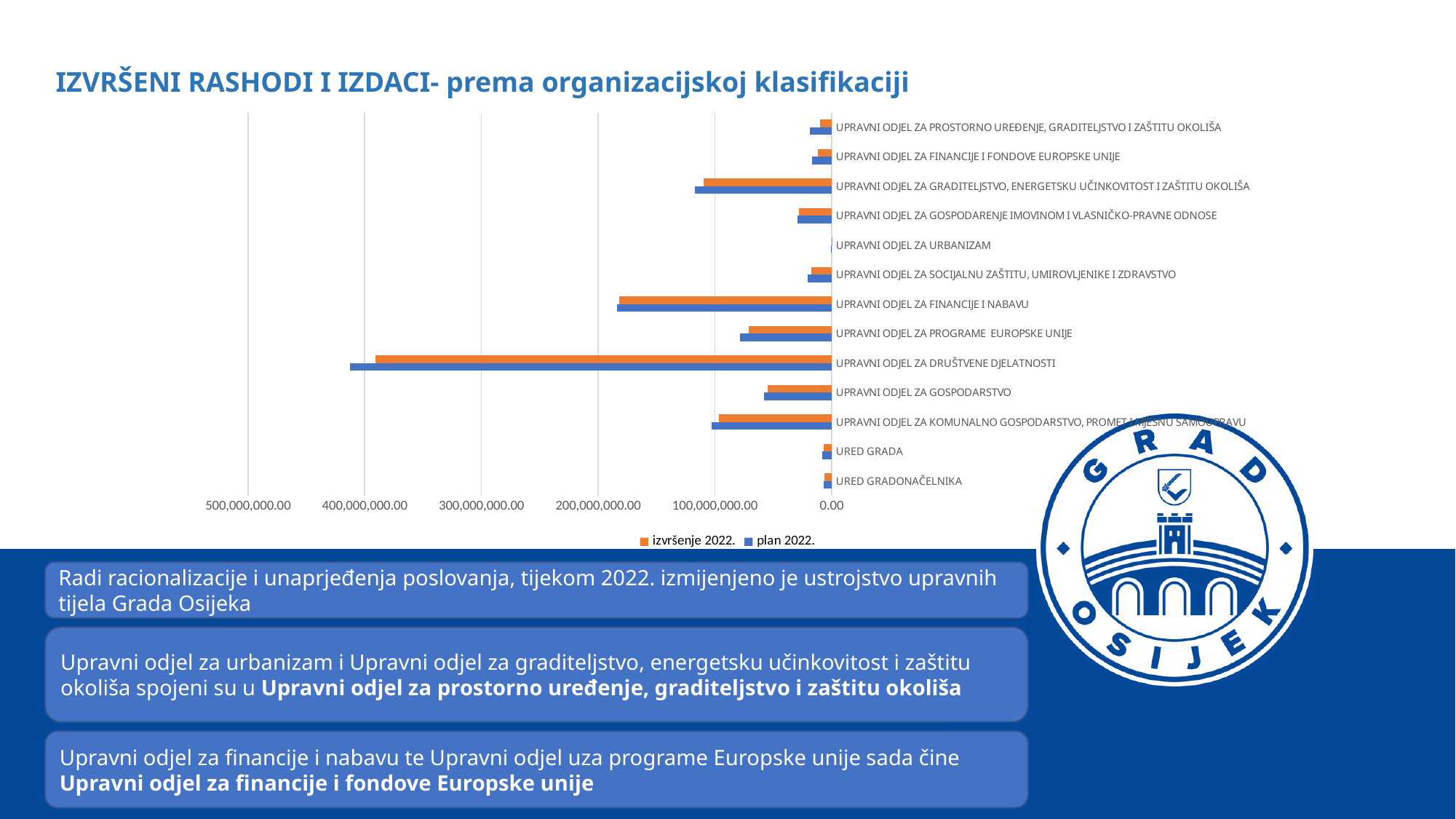
What are the two series named in the chart legend? izvršenje 2022. and plan 2022. How many series does the chart legend list? 2 Which is larger for UPRAVNI ODJEL ZA DRUŠTVENE DJELATNOSTI: the plan 2022. value or the izvršenje 2022. value? plan 2022. How many organisational units (categories) are shown in the chart? 13 Which has the larger plan 2022. value: UPRAVNI ODJEL ZA PROGRAME EUROPSKE UNIJE or UPRAVNI ODJEL ZA GOSPODARSTVO? UPRAVNI ODJEL ZA PROGRAME EUROPSKE UNIJE Is the plan 2022. value for UPRAVNI ODJEL ZA GOSPODARSTVO greater or less than 100,000,000.00? less Which organisational unit has the highest values in the chart? UPRAVNI ODJEL ZA DRUŠTVENE DJELATNOSTI What is the title of the chart on the slide? IZVRŠENI RASHODI I IZDACI- prema organizacijskoj klasifikaciji Is the izvršenje 2022. value for UPRAVNI ODJEL ZA FINANCIJE I NABAVU greater or less than 200,000,000.00? less What kind of chart is shown on the slide? bar chart Which organisational unit has the lowest values in the chart? UPRAVNI ODJEL ZA URBANIZAM Is the plan 2022. value for UPRAVNI ODJEL ZA DRUŠTVENE DJELATNOSTI greater or less than 400,000,000.00? greater